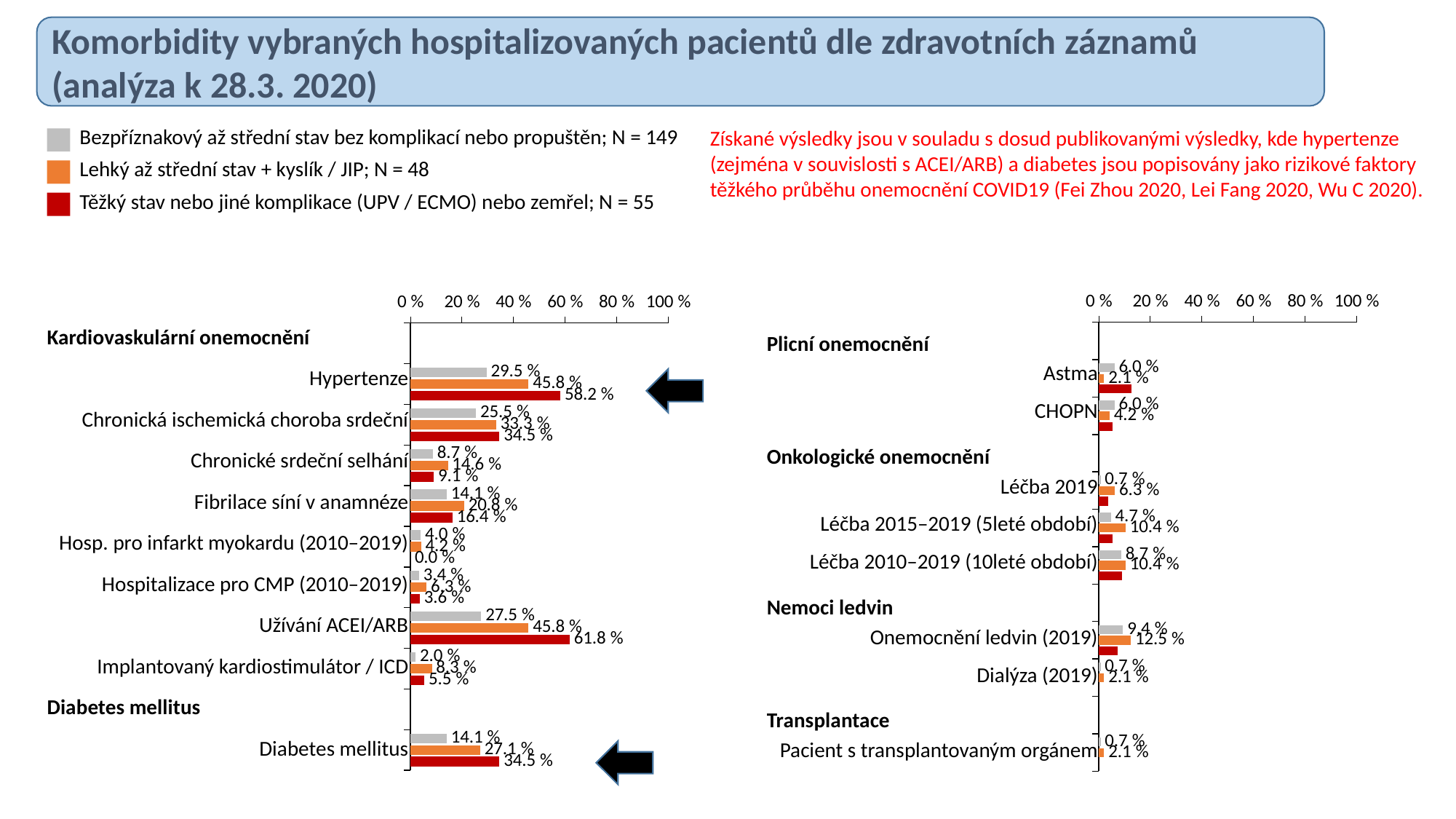
On the left chart, which category has the lowest value in the 'Bezpříznakový až střední stav bez komplikací nebo propuštěn' series? Implantovaný kardiostimulátor / ICD On the left chart, what is the difference between the 'Těžký stav' value and the 'Bezpříznakový až střední stav' value for Hypertenze? 28.7 % On the left chart, which category has the highest value in the 'Těžký stav nebo jiné komplikace (UPV / ECMO) nebo zemřel' series? Užívání ACEI/ARB On the right chart, what is the value for Onemocnění ledvin (2019) in the 'Lehký až střední stav + kyslík / JIP' series? 12.5 % What colour represents the 'Těžký stav nebo jiné komplikace (UPV / ECMO) nebo zemřel' series? Red What kind of chart is used on the left side of the slide? Bar chart On the left chart, for Diabetes mellitus, which is larger: the 'Lehký až střední stav + kyslík / JIP' value or the 'Těžký stav' value? Těžký stav (34.5 %) On the left chart, what is the value for Diabetes mellitus in the 'Bezpříznakový až střední stav bez komplikací nebo propuštěn' series? 14.1 % On the right chart, is the 'Lehký až střední stav + kyslík / JIP' value for Léčba 2015–2019 (5leté období) greater or less than 20 %? less How many series does the legend list? 3 On the left chart, what is the value for Užívání ACEI/ARB in the 'Lehký až střední stav + kyslík / JIP' series? 45.8 % On the left chart, what is the value for Hypertenze in the 'Těžký stav nebo jiné komplikace (UPV / ECMO) nebo zemřel' series? 58.2 %